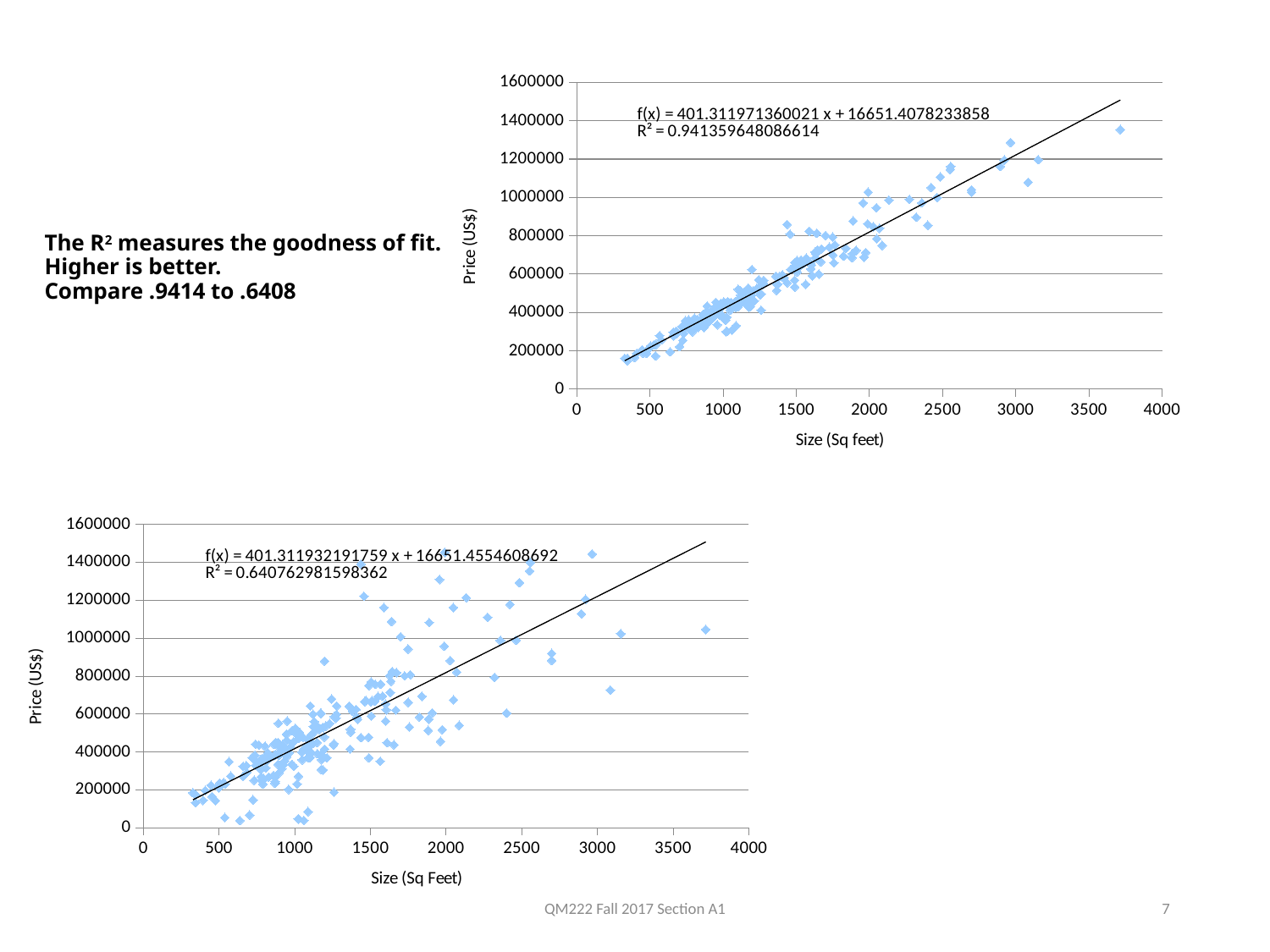
In the bottom chart, what is the fitted equation printed on the chart? f(x) = 401.311932191759 x + 16651.4554608692 What is the label of the y axis in the top chart? Price (US$) In the top chart, what is the R² value printed on the chart? 0.941359648086614 How many charts are shown on the slide? 2 In the top chart, is the price of the point with the largest size (around 3700 sq feet) greater or less than 1200000? greater Which chart has the higher R² value, the top chart or the bottom chart? the top chart In the bottom chart, what is the R² value printed on the chart? 0.640762981598362 What kind of chart is the top chart on the slide? scatter chart In the top chart, what is the fitted equation printed on the chart? f(x) = 401.311971360021 x + 16651.4078233858 In the top chart, do prices generally rise or fall as size increases along the x axis? rise What kind of chart is the bottom chart on the slide? scatter chart In the bottom chart, is the price of the point with the largest size (around 3700 sq feet) greater or less than 800000? greater